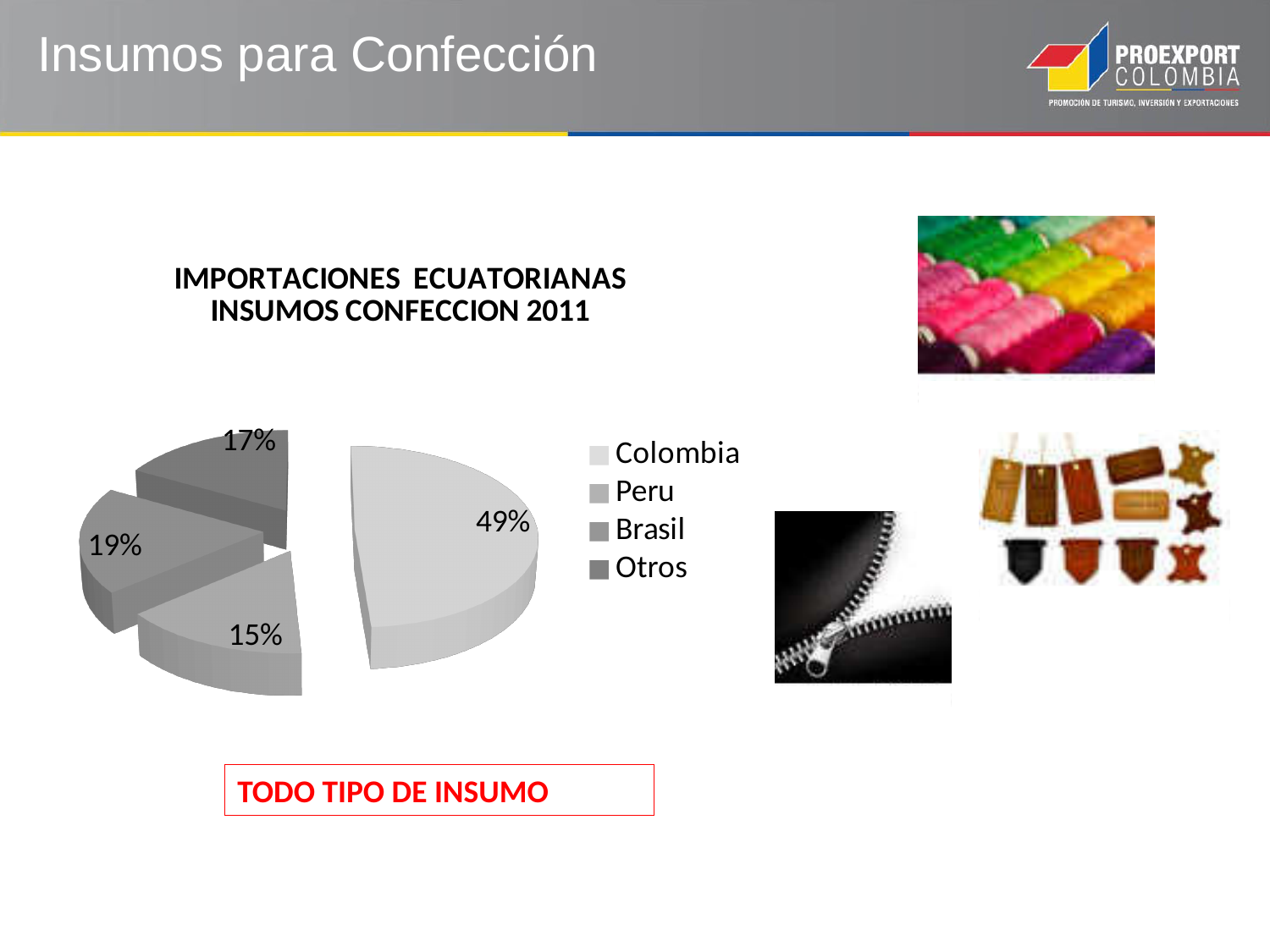
What kind of chart is shown on the slide? pie chart What share of the pie does Otros hold? 17% Which is larger, the share for Brasil or the share for Otros? Brasil What share of the pie does Colombia hold? 49% Which category has the largest share of the pie? Colombia How many entries does the legend list? 4 What is the difference between the shares of Colombia and Brasil? 30% What share of the pie does Brasil hold? 19% What is the title of the chart? IMPORTACIONES ECUATORIANAS INSUMOS CONFECCION 2011 Which category has the smallest share of the pie? Peru How many slices does the pie chart have? 4